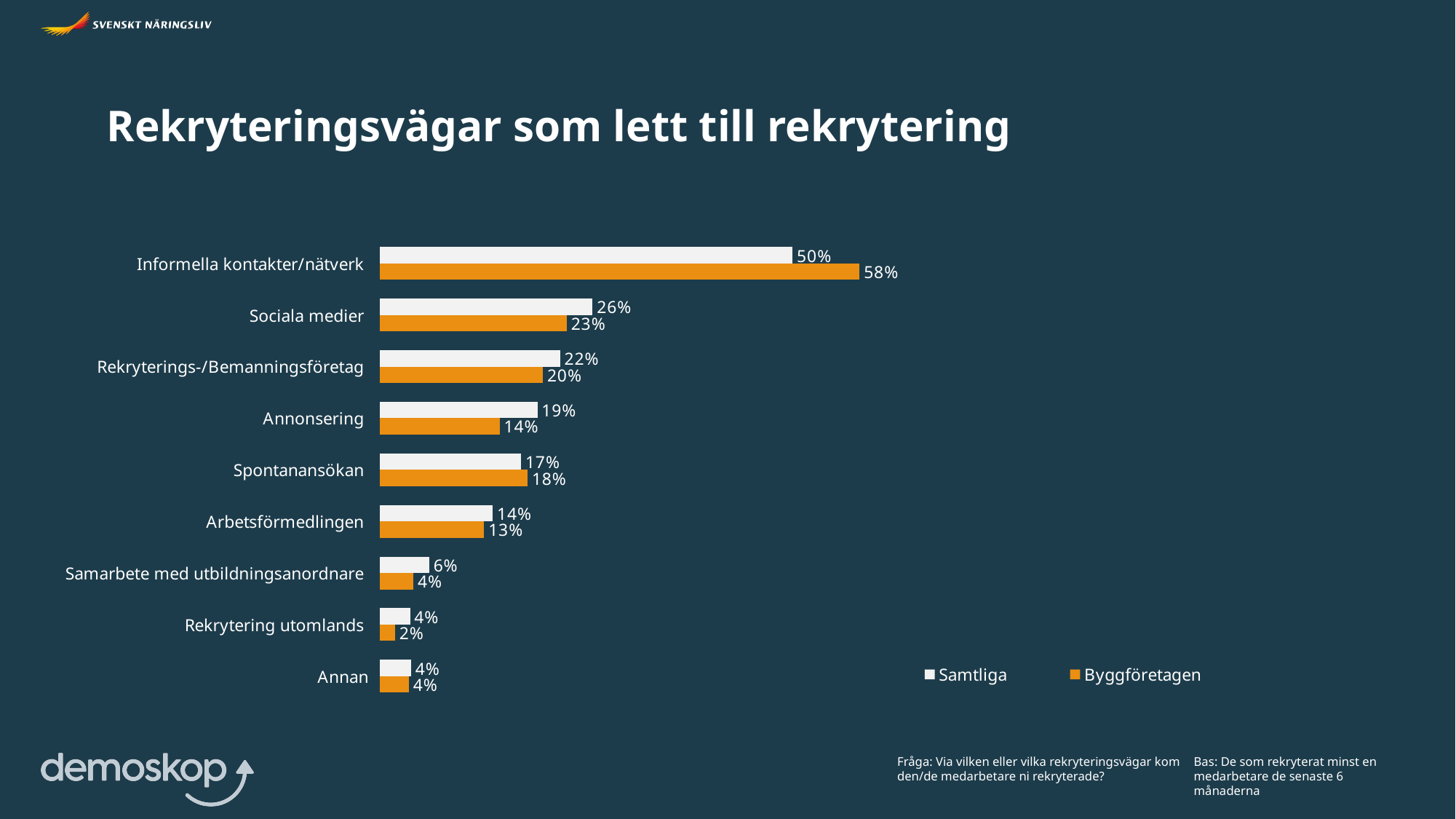
What is the value for Byggföretagen for Annonsering? 14% Which category has the lowest value for Byggföretagen? Rekrytering utomlands What kind of chart is shown on the slide? Bar chart How many categories are shown in the chart? 9 Which is larger for Spontanansökan, Samtliga or Byggföretagen? Byggföretagen How many series does the legend list? 2 Which category has the highest value for Samtliga? Informella kontakter/nätverk What is the difference between Byggföretagen and Samtliga for Informella kontakter/nätverk? 8 percentage points What is the title of the chart? Rekryteringsvägar som lett till rekrytering Which is larger for Rekryterings-/Bemanningsföretag, Samtliga or Byggföretagen? Samtliga What is the value for Samtliga for Sociala medier? 26% What is the value for Byggföretagen for Informella kontakter/nätverk? 58%